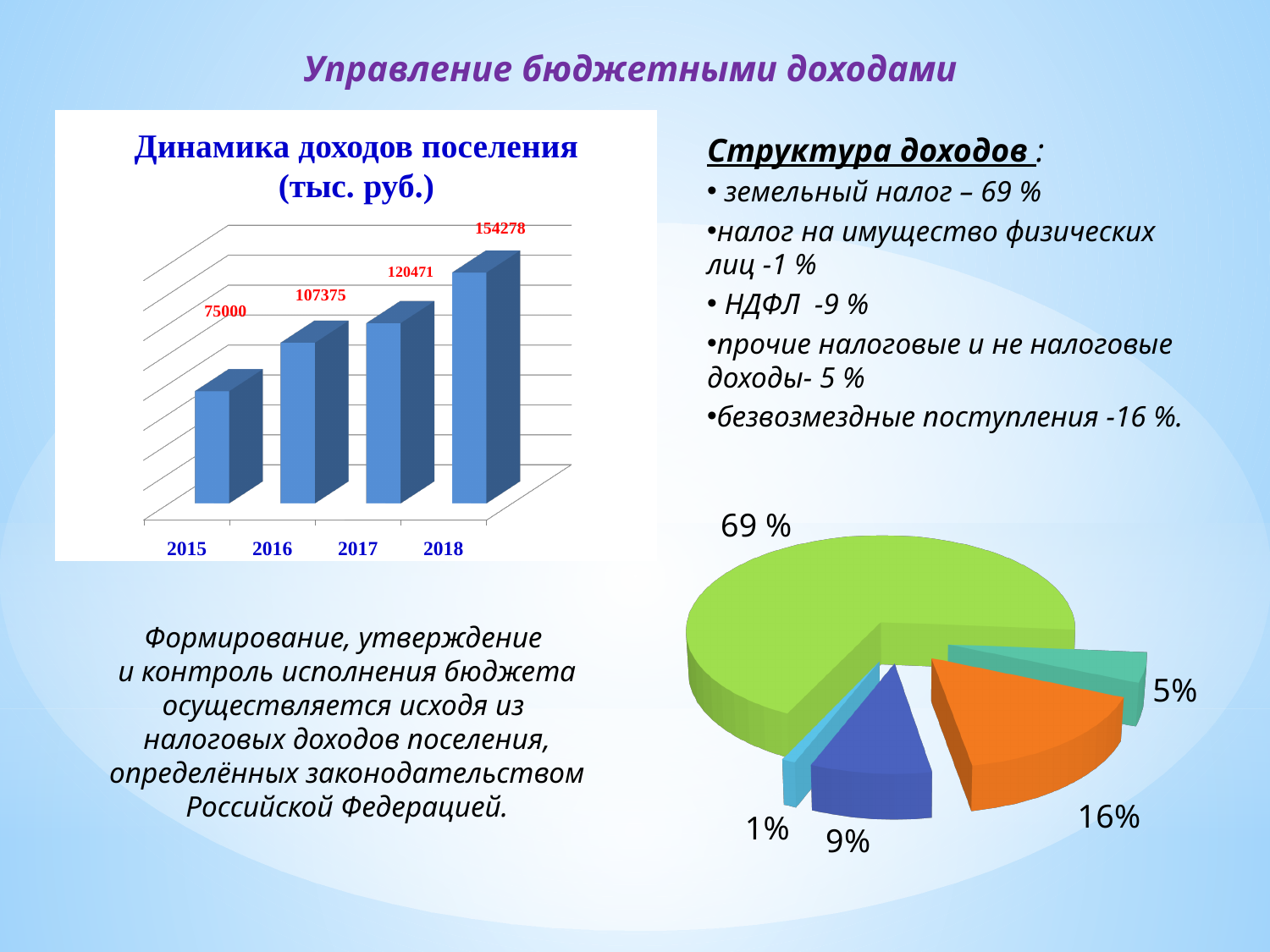
On the bar chart 'Динамика доходов поселения (тыс. руб.)', what is the value for 2017? 120471 What kind of chart is the chart on the left side of the slide? bar chart On the bar chart 'Динамика доходов поселения (тыс. руб.)', which year has the highest value? 2018 On the bar chart 'Динамика доходов поселения (тыс. руб.)', what is the value for 2015? 75000 On the bar chart 'Динамика доходов поселения (тыс. руб.)', which year has the lowest value? 2015 On the bar chart 'Динамика доходов поселения (тыс. руб.)', which is larger, the value for 2016 or the value for 2017? 2017 On the bar chart 'Динамика доходов поселения (тыс. руб.)', what is the difference between the 2018 and 2015 values? 79278 On the bar chart 'Динамика доходов поселения (тыс. руб.)', what is the difference between the 2016 and 2015 values? 32375 On the pie chart at the bottom right of the slide, how many slices are there? 5 On the bar chart 'Динамика доходов поселения (тыс. руб.)', how many years are shown? 4 On the bar chart 'Динамика доходов поселения (тыс. руб.)', do the values rise or fall from 2015 to 2018? rise On the pie chart at the bottom right of the slide, what is the share of the largest slice? 69 %